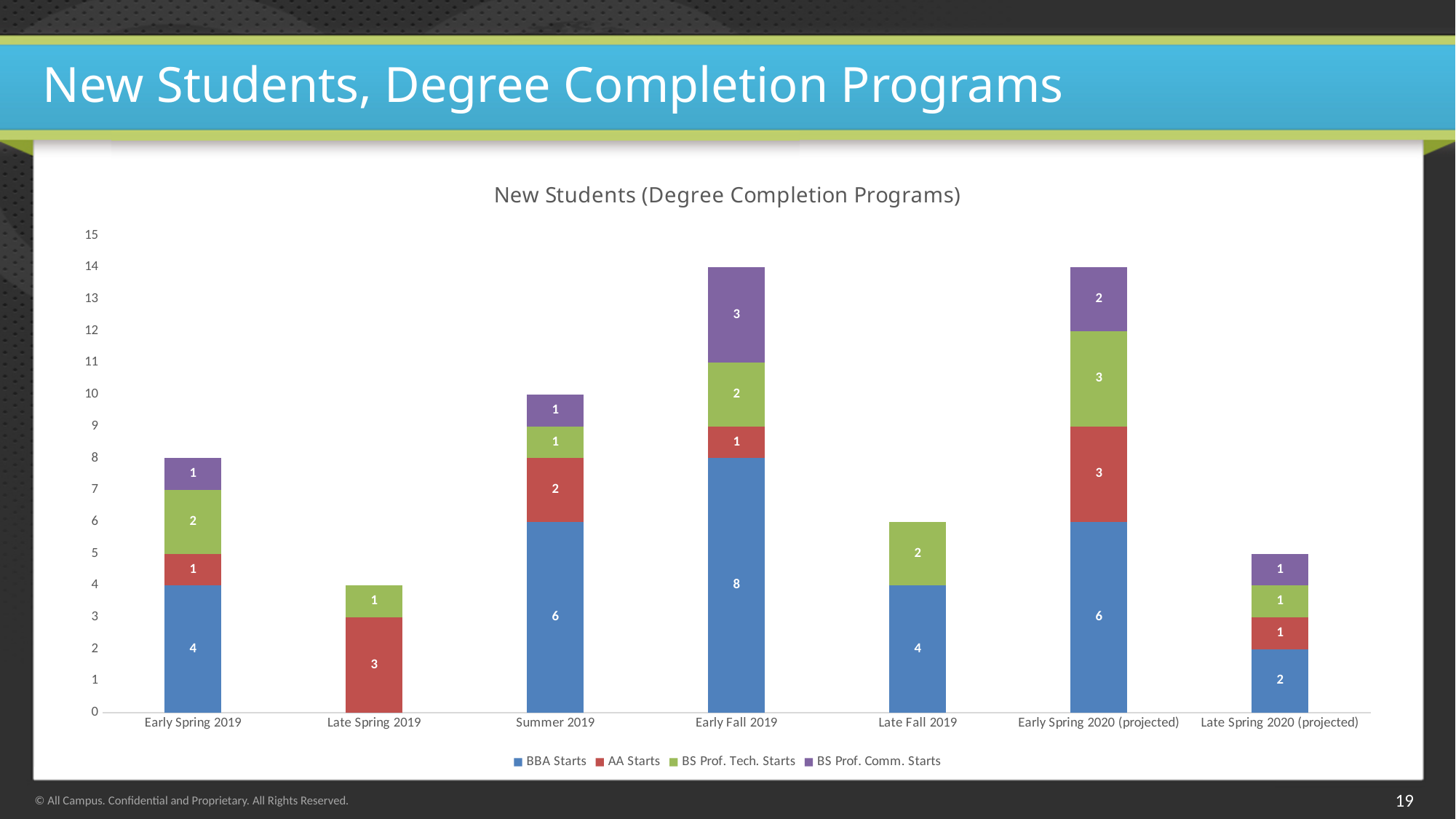
Which category has the highest value for BBA Starts? Early Fall 2019 What is the total of the stacked bar for Summer 2019? 10 How many categories are shown on the x axis? 7 What is the value of BS Prof. Comm. Starts for Early Spring 2020 (projected)? 2 What is the value of AA Starts for Late Spring 2019? 3 What type of chart is shown on the slide? Stacked bar chart Which is larger: AA Starts for Summer 2019 or AA Starts for Early Spring 2020 (projected)? Early Spring 2020 (projected) How many series does the legend list? 4 What is the total of the stacked bar for Early Spring 2019? 8 Which category has the lowest total stacked bar? Late Spring 2019 What is the difference between BBA Starts for Early Fall 2019 and BBA Starts for Late Fall 2019? 4 What is the value of BBA Starts for Early Fall 2019? 8